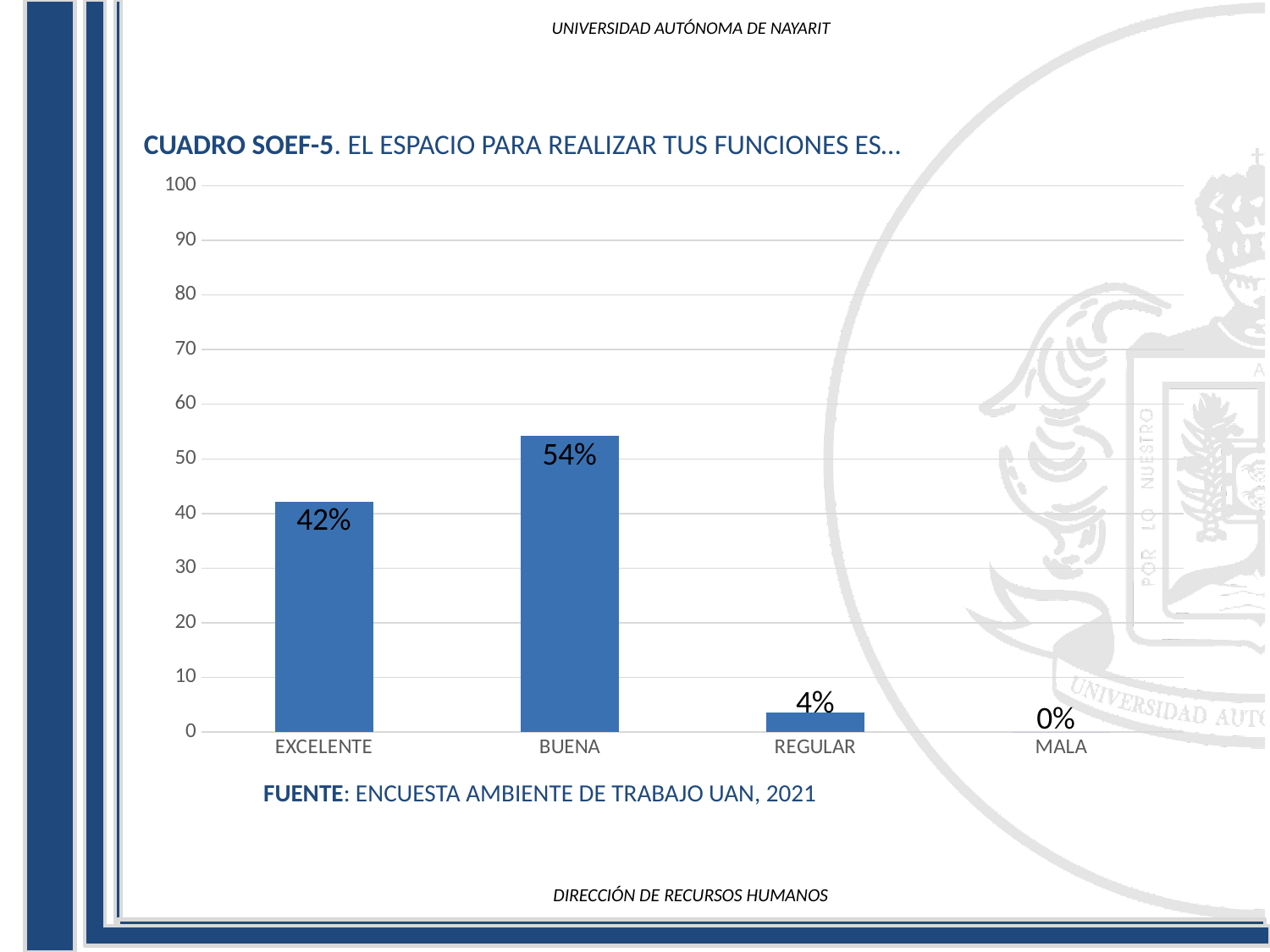
What kind of chart is shown on the slide? bar chart What is the value for BUENA? 54% Which is larger, the value for EXCELENTE or the value for REGULAR? EXCELENTE Is the value for BUENA greater or less than 50? greater What is the title of the chart? CUADRO SOEF-5. EL ESPACIO PARA REALIZAR TUS FUNCIONES ES… What is the value for REGULAR? 4% What is the difference between the values for BUENA and EXCELENTE? 12% Which category has the highest value? BUENA How many categories are shown on the x axis? 4 Which category has the lowest value? MALA What is the value for MALA? 0% What is the value for EXCELENTE? 42%